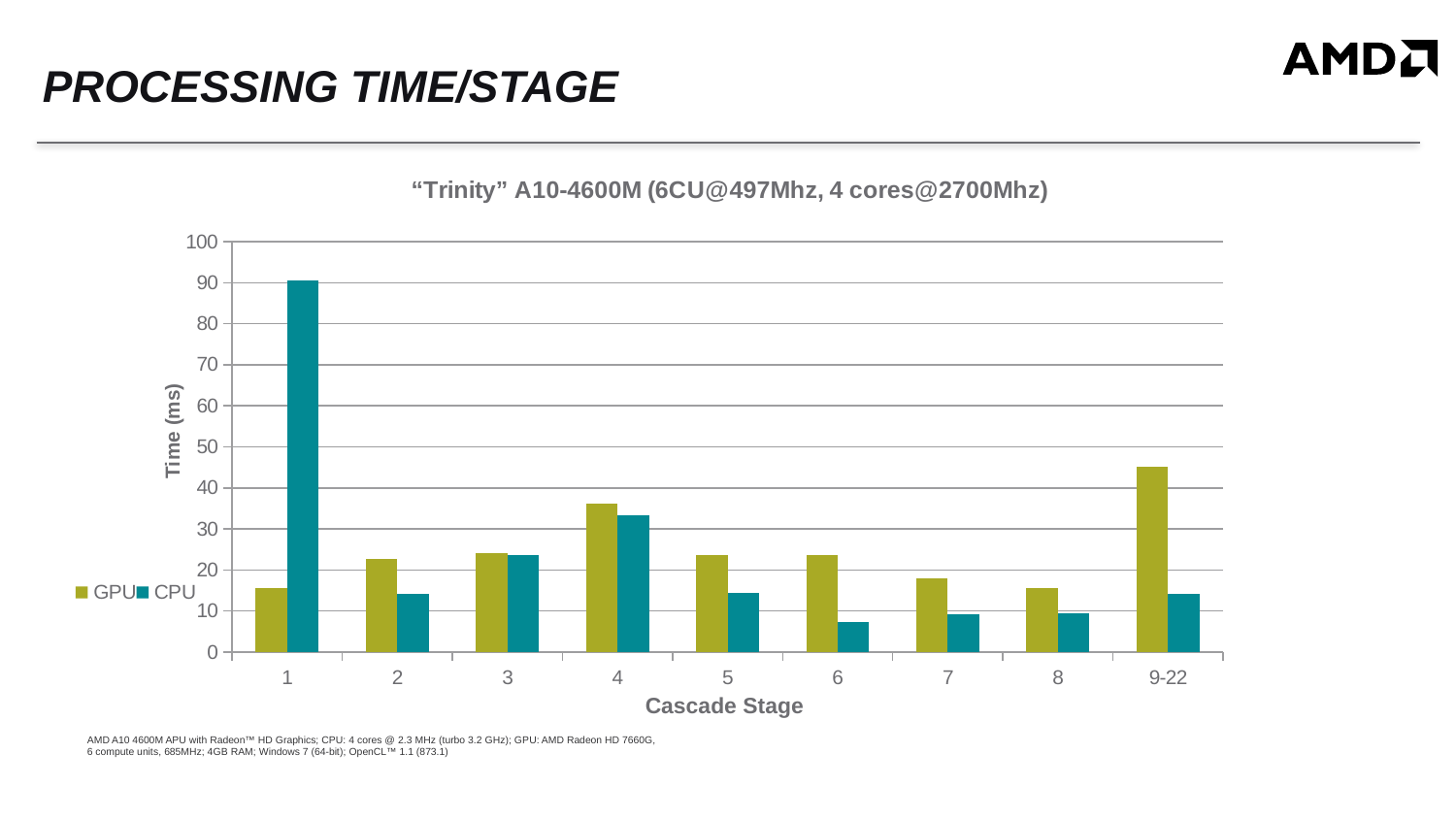
Is the CPU time for cascade stage 1 greater or less than 80 ms? greater At cascade stage 6, which is larger, the GPU time or the CPU time? GPU Which cascade stage has the highest GPU time? 9-22 At cascade stage 1, which is larger, the GPU time or the CPU time? CPU How many cascade stage categories are shown on the x axis? 9 How many series does the legend list? 2 Which cascade stage has the highest CPU time? 1 What is the label of the y axis? Time (ms) Is the GPU time for cascade stage 9-22 greater or less than 40 ms? greater What kind of chart is shown on the slide? Bar chart Is the CPU time for cascade stage 6 greater or less than 10 ms? less Which cascade stage has the lowest CPU time? 6